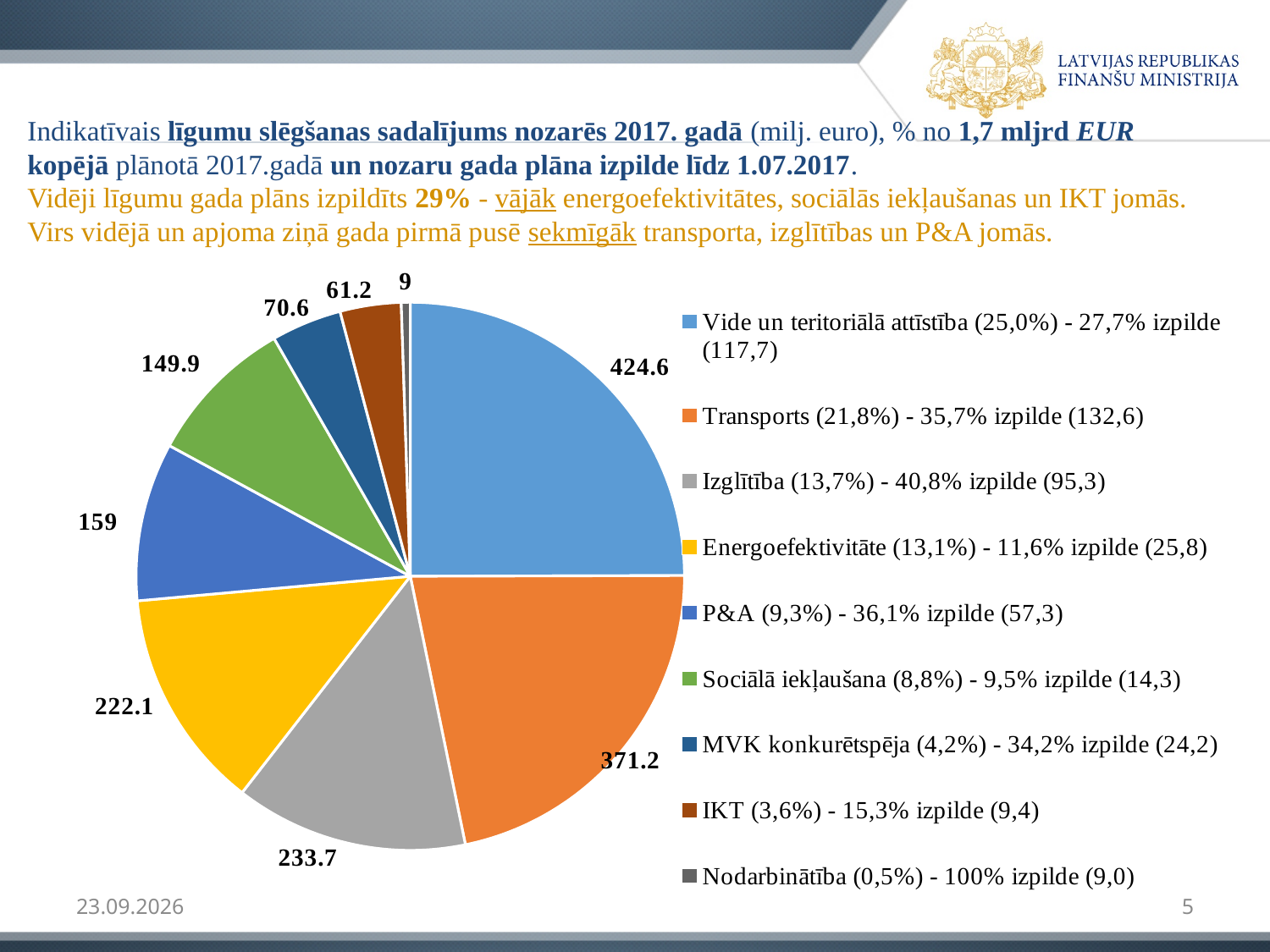
What is the difference between the values for Vide un teritoriālā attīstība and Transports? 53.4 What is the value shown for the Energoefektivitāte slice? 222.1 Which is larger, the value for Izglītība or the value for Energoefektivitāte? Izglītība What is the value shown for the Sociālā iekļaušana slice? 149.9 How many entries does the legend of the pie chart list? 9 What is the value shown for the Transports slice? 371.2 How many slices does the pie chart have? 9 What type of chart is shown on the slide? pie chart According to the legend, what share of the pie does Transports represent? 21,8% Which category has the smallest slice in the pie chart? Nodarbinātība Which category has the largest slice in the pie chart? Vide un teritoriālā attīstība What colour is the slice for IKT in the pie chart? brown